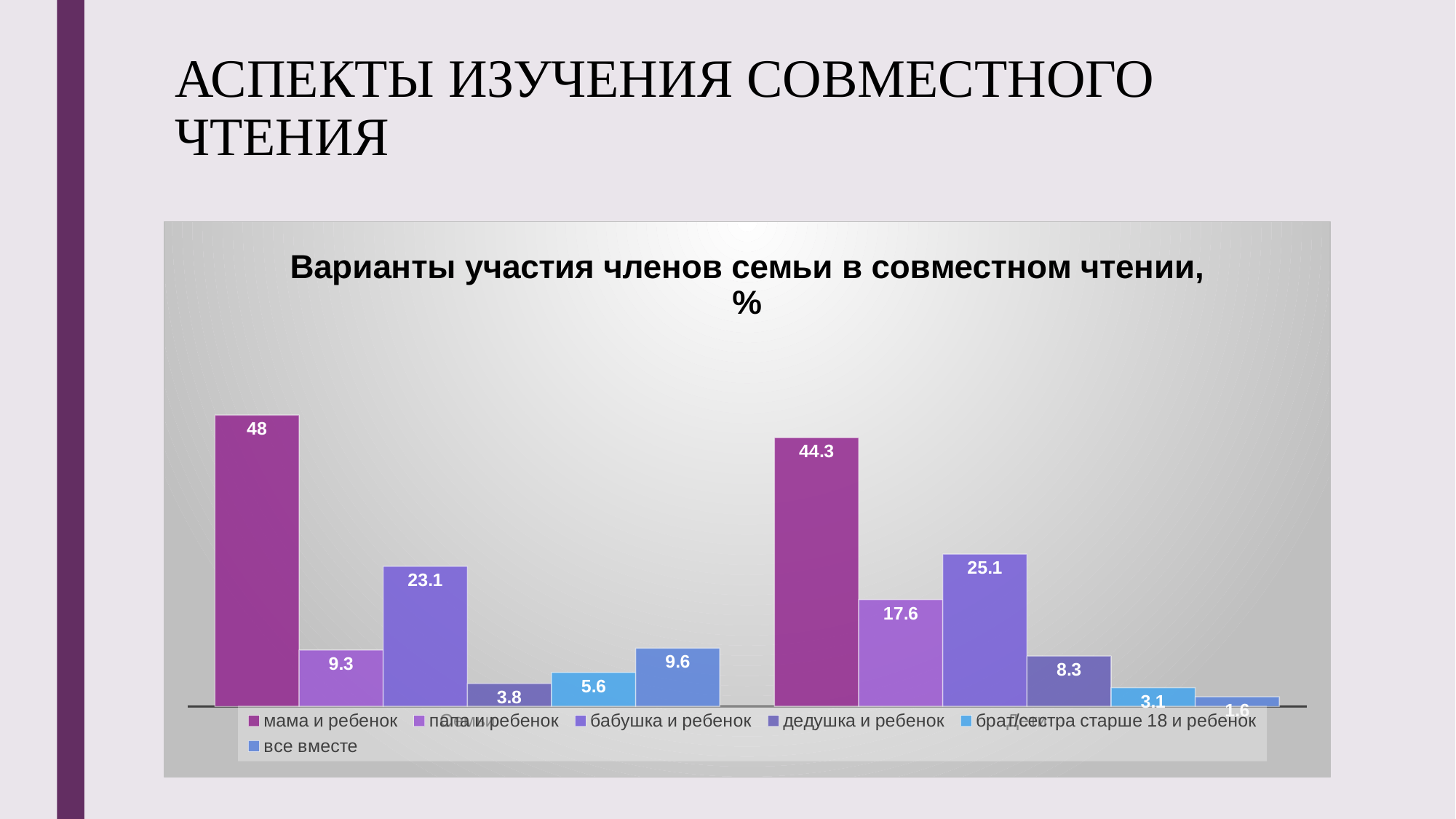
How many series does the legend list? 6 Which series has the lowest value in the left group of bars? дедушка и ребенок What is the difference between the "мама и ребенок" values in the left and right groups of bars? 3.7 What is the value for "бабушка и ребенок" in the right group of bars? 25.1 What is the title of the chart? Варианты участия членов семьи в совместном чтении, % Which is larger: "дедушка и ребенок" in the left group or "дедушка и ребенок" in the right group? the right group (8.3) What kind of chart is shown on the slide? bar chart Which series has the highest value in the right group of bars? мама и ребенок What is the value for "все вместе" in the left group of bars? 9.6 What is the value for "папа и ребенок" in the right group of bars? 17.6 Which series has the lowest value in the right group of bars? все вместе What is the value for "мама и ребенок" in the left group of bars? 48